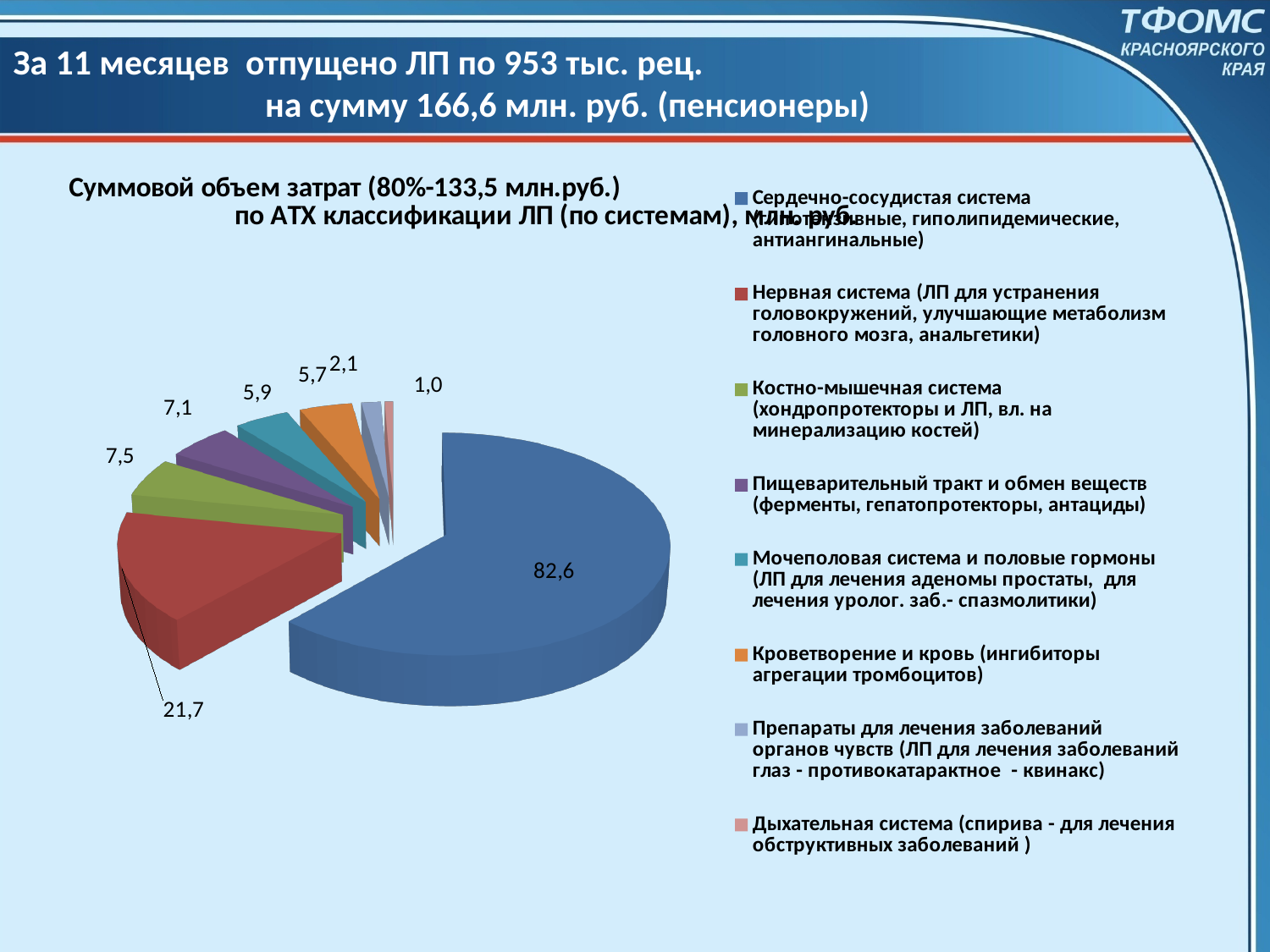
What value is shown for the slice «Нервная система» in the pie chart? 21,7 Which category has the smallest slice in the pie chart? Дыхательная система What is the difference between the values for «Сердечно-сосудистая система» and «Нервная система»? 60,9 Which category has the largest slice in the pie chart? Сердечно-сосудистая система What value is shown for the slice «Костно-мышечная система» in the pie chart? 7,5 What is the difference between the values for «Нервная система» and «Костно-мышечная система»? 14,2 Which is larger: the value for «Костно-мышечная система» or for «Пищеварительный тракт и обмен веществ»? Костно-мышечная система What value is shown for the slice «Дыхательная система» in the pie chart? 1,0 How many slices does the pie chart have? 8 What type of chart is shown on the slide? Pie chart What value is shown for the slice «Сердечно-сосудистая система» in the pie chart? 82,6 What colour is the slice for «Кроветворение и кровь» in the pie chart? Orange